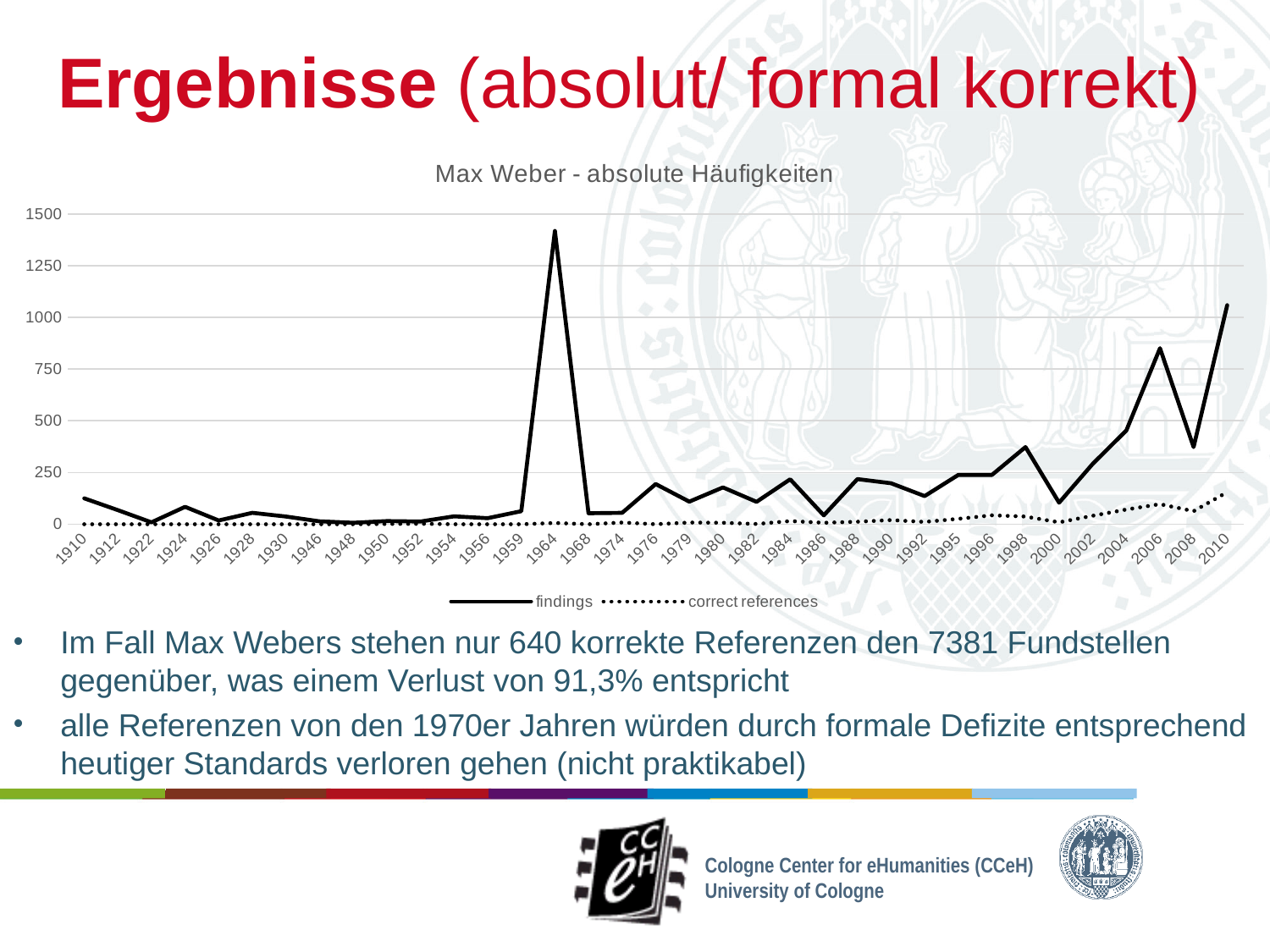
Is the value of findings in 2010 greater or less than 1000? greater Which series is drawn with a dotted line? correct references In which year does the findings series reach its highest value? 1964 Which is larger, the findings value in 1964 or in 2010? 1964 Is the value of findings in 2008 greater or less than 500? less Does the findings series rise or fall between 2000 and 2006? rise What kind of chart is shown on the slide? line chart What is the title of the chart? Max Weber - absolute Häufigkeiten How many series does the legend list? 2 Is the value of findings in 1964 greater or less than 1250? greater